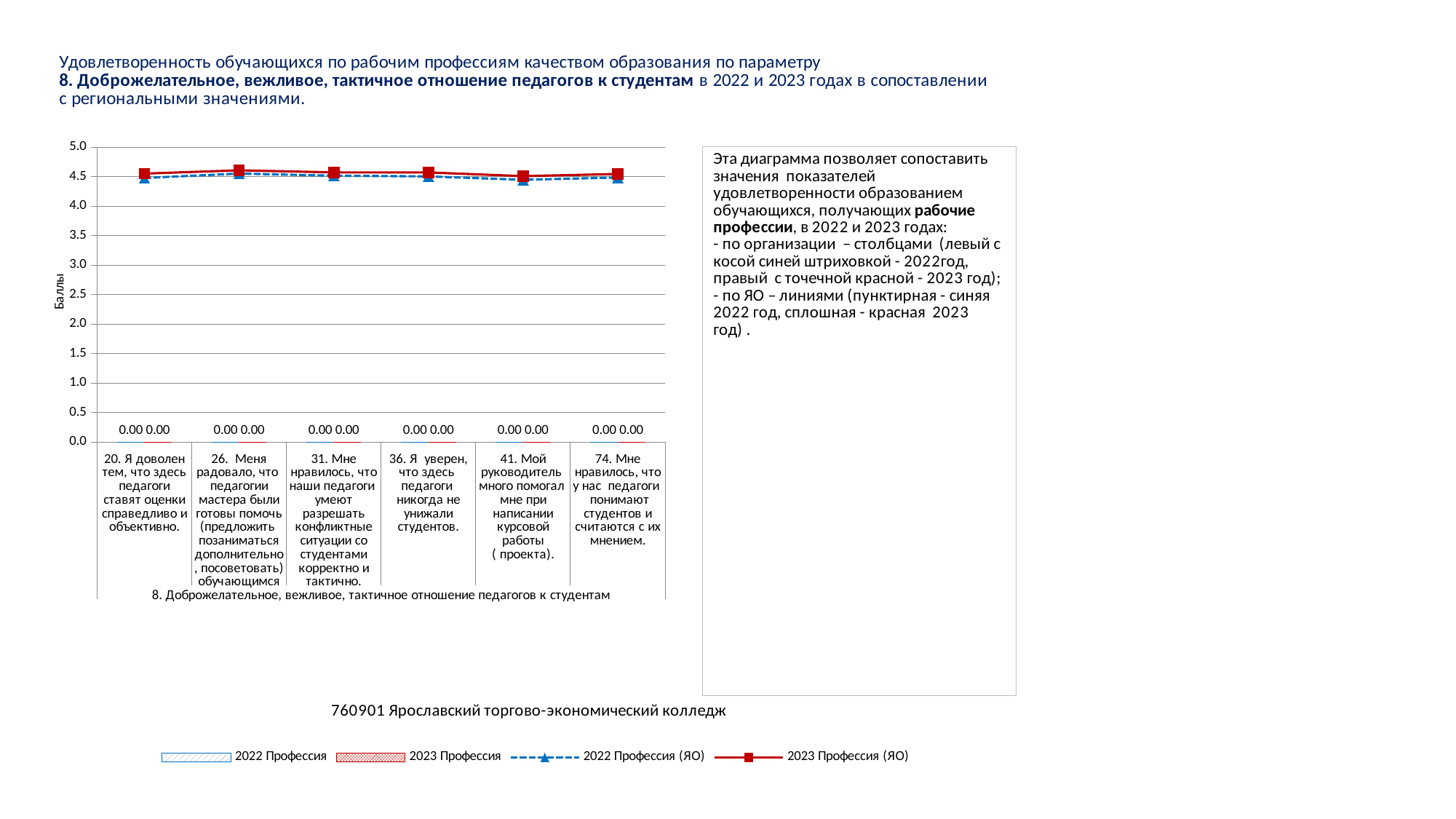
How many series does the chart legend list? 4 For category "26. Меня радовало, что педагогии мастера были готовы помочь...", which line is higher: 2022 Профессия (ЯО) or 2023 Профессия (ЯО)? 2023 Профессия (ЯО) Is the value of the 2022 Профессия (ЯО) line for category "41. Мой руководитель много помогал мне при написании курсовой работы ( проекта)." greater or less than 5.0? less Is the value of the 2023 Профессия (ЯО) line for category "26. Меня радовало, что педагогии мастера были готовы помочь..." greater or less than 4.0? greater What is the printed value of the 2023 Профессия series for category "41. Мой руководитель много помогал мне при написании курсовой работы ( проекта)."? 0.00 How many categories are shown on the x axis of the chart? 6 What is the label of the vertical axis of the chart? Баллы What is the printed value of the 2023 Профессия series for category "74. Мне нравилось, что у нас педагоги понимают студентов и считаются с их мнением."? 0.00 What kind of chart is shown on the slide? Combined bar and line chart What colour is the 2023 Профессия (ЯО) line in the chart? Red Is the value of the 2022 Профессия (ЯО) line for category "36. Я уверен, что здесь педагоги никогда не унижали студентов." greater or less than 4.0? greater What is the printed value of the 2022 Профессия series for category "20. Я доволен тем, что здесь педагоги ставят оценки справедливо и объективно."? 0.00